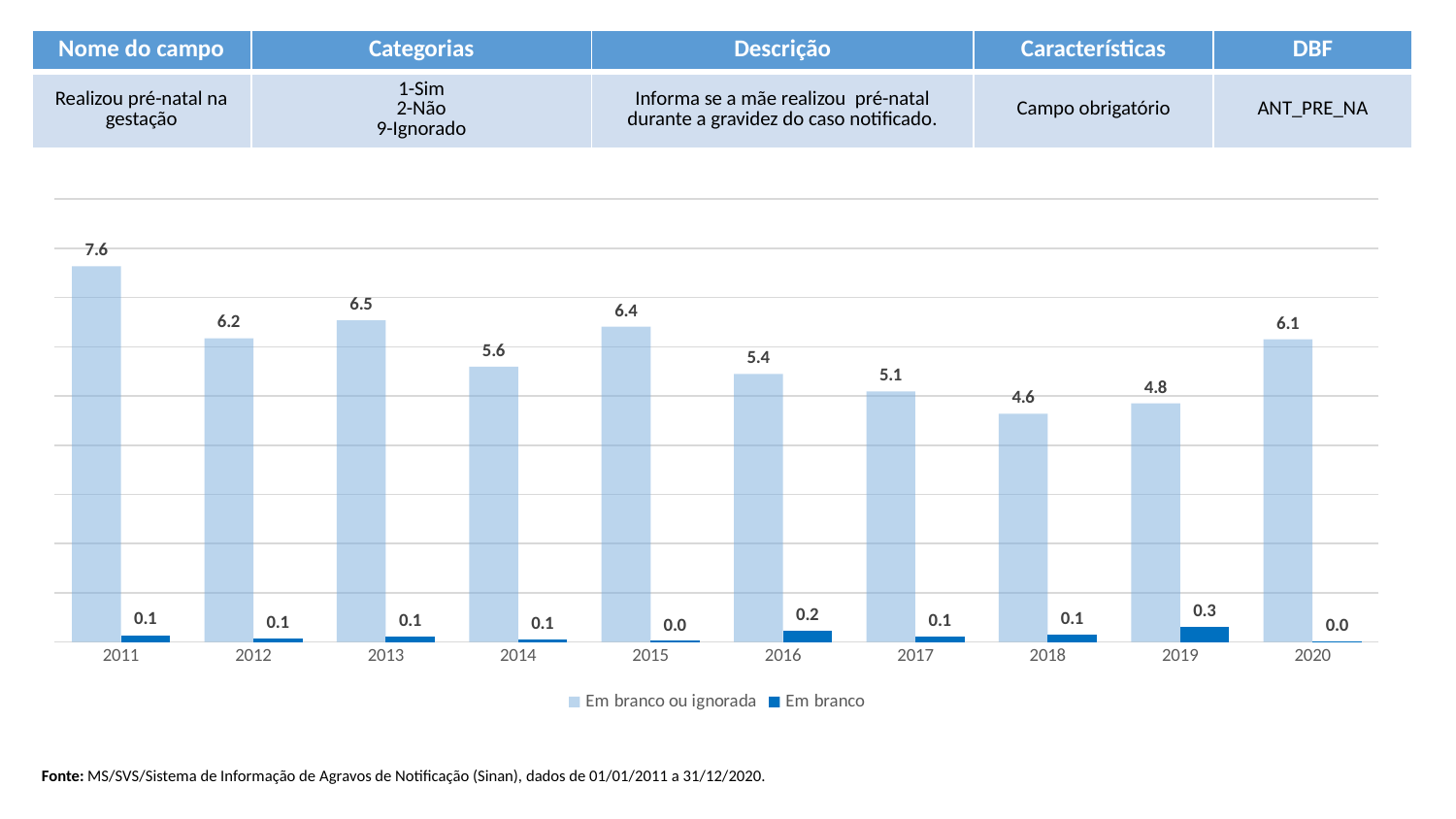
What kind of chart is shown on the slide? Bar chart How many years are shown on the x axis? 10 What is the value for "Em branco ou ignorada" in 2011? 7.6 Which year has the highest value for "Em branco ou ignorada"? 2011 Which year has the highest value for "Em branco"? 2019 Which is larger, the "Em branco ou ignorada" value for 2013 or for 2015? 2013 What is the value for "Em branco" in 2019? 0.3 Which year has the lowest value for "Em branco ou ignorada"? 2018 What is the value for "Em branco ou ignorada" in 2018? 4.6 How many series does the legend list? 2 Does the "Em branco ou ignorada" value rise or fall from 2019 to 2020? Rise What is the difference between the "Em branco ou ignorada" values for 2011 and 2020? 1.5